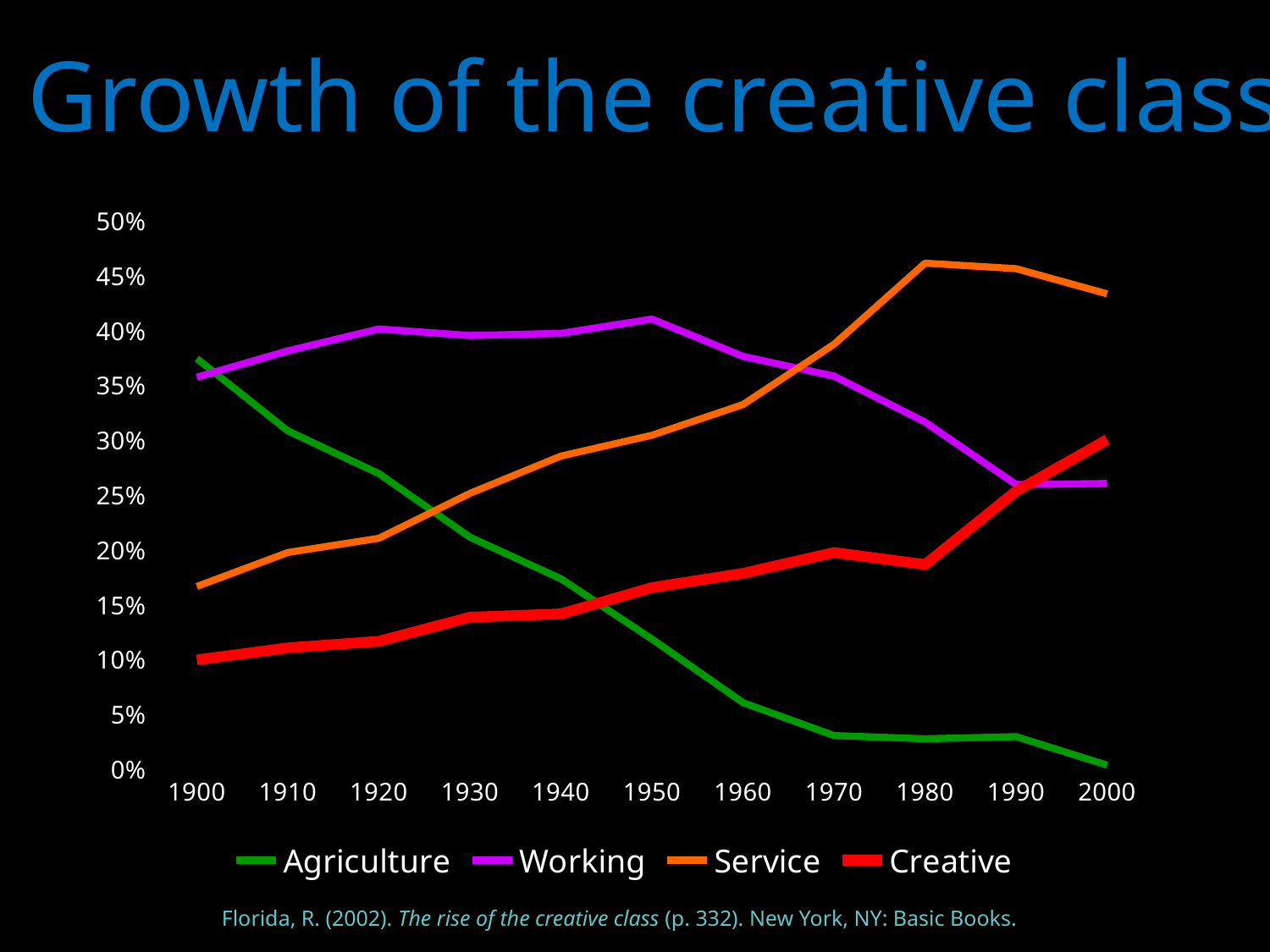
What kind of chart is shown on the slide? line chart Is the value for Agriculture in 1900 greater or less than 35%? greater Is the value for Working in 1920 greater or less than 35%? greater Which series has the highest value in 1950? Working How many series does the legend list? 4 Which series has the lowest value in 2000? Agriculture Is the value for Creative in 2000 greater or less than 25%? greater How many years are marked along the x axis? 11 Does the Agriculture line rise or fall from 1900 to 2000? fall Does the Service line generally rise or fall from 1900 to 1980? rise In 2000, which is larger, the Service value or the Working value? Service